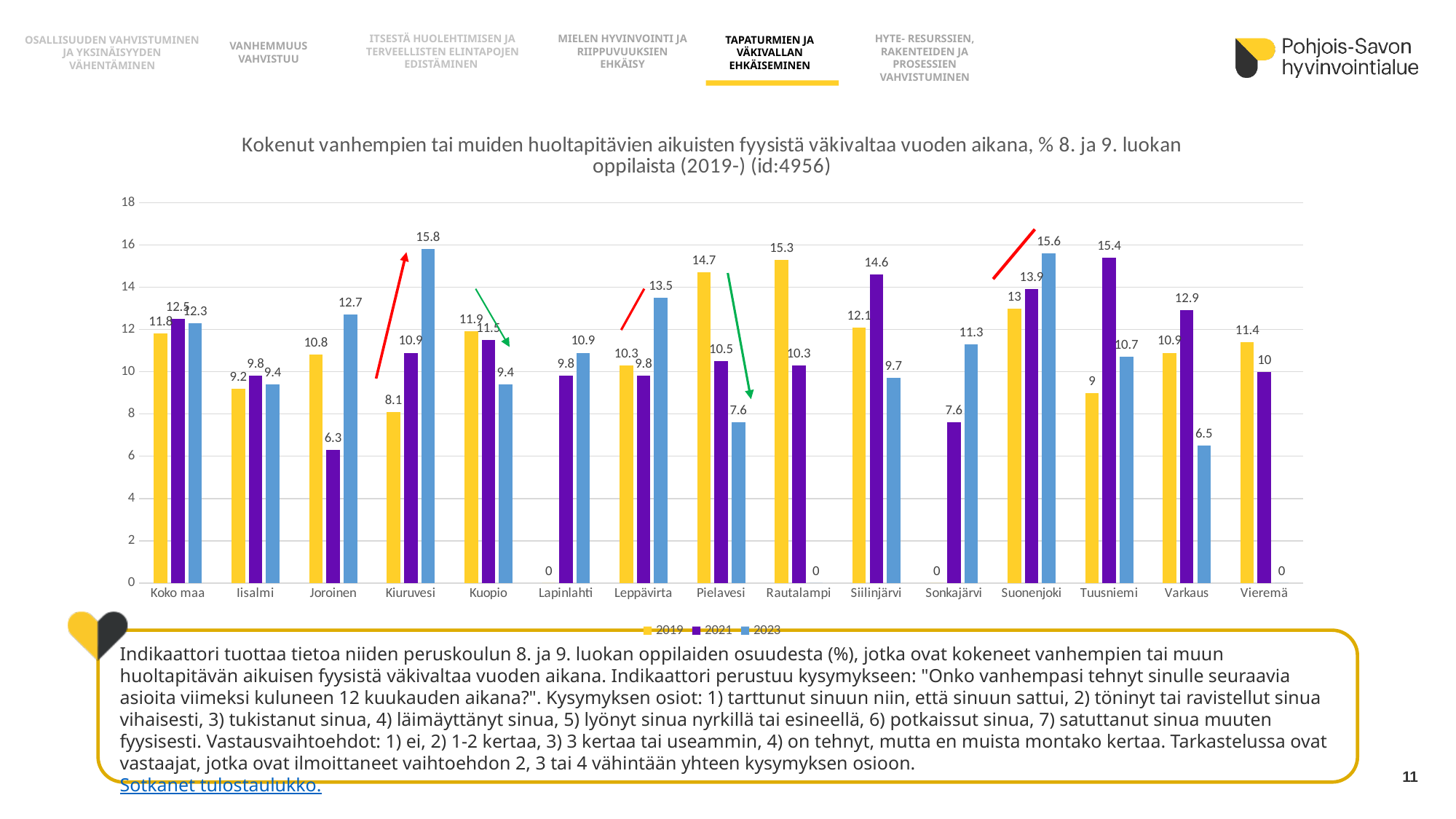
How many municipalities/categories are shown on the x axis? 15 Which category has the lowest non-zero 2021 value? Joroinen What is the 2021 value for Joroinen? 6.3 How many series does the legend list? 3 What kind of chart is shown on the slide? Bar chart What is the difference between the 2023 and 2019 values for Kiuruvesi? 7.7 Do the values for Sonkajärvi rise or fall from 2021 to 2023? Rise What is the 2023 value for Kiuruvesi? 15.8 Which is larger for Pielavesi, the 2019 value or the 2023 value? 2019 Which colour represents the 2021 series in the legend? Purple Which municipality has the highest 2023 value? Kiuruvesi What is the 2019 value for Pielavesi? 14.7